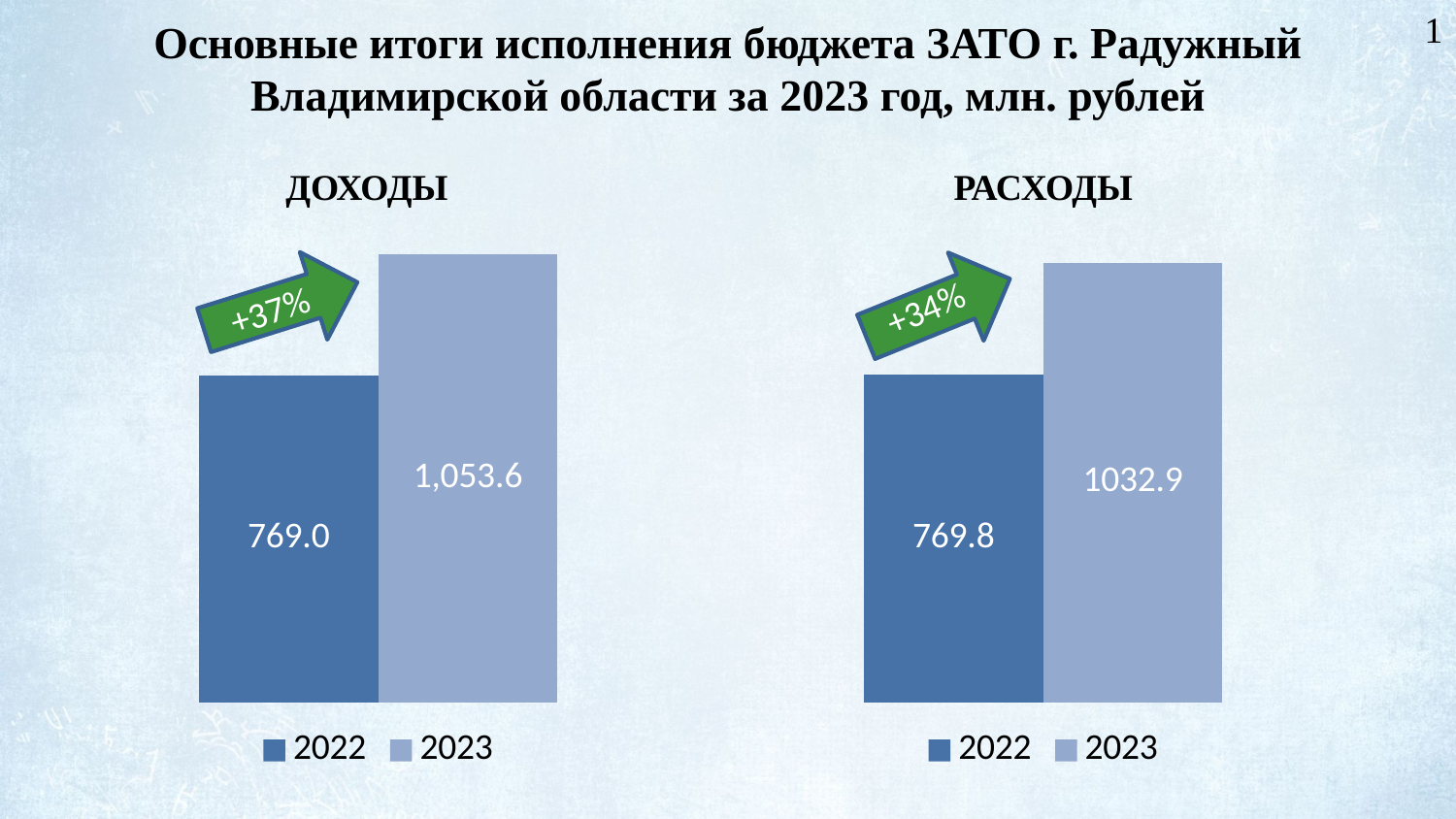
In the ДОХОДЫ chart, what is the difference between the 2023 and 2022 values? 284.6 What percentage increase is shown by the arrow on the РАСХОДЫ chart? +34% What kind of chart is the РАСХОДЫ chart? Bar chart In the РАСХОДЫ chart, what is the value for 2023? 1032.9 In the РАСХОДЫ chart, which year has the lower value? 2022 How many series does the legend of the ДОХОДЫ chart list? 2 In the ДОХОДЫ chart, which year has the higher value? 2023 Is the 2023 value in the ДОХОДЫ chart larger than the 2023 value in the РАСХОДЫ chart? Yes In the ДОХОДЫ chart, what is the value for 2022? 769.0 In the ДОХОДЫ chart, what is the value for 2023? 1,053.6 In the РАСХОДЫ chart, what is the value for 2022? 769.8 In the РАСХОДЫ chart, what is the difference between the 2023 and 2022 values? 263.1